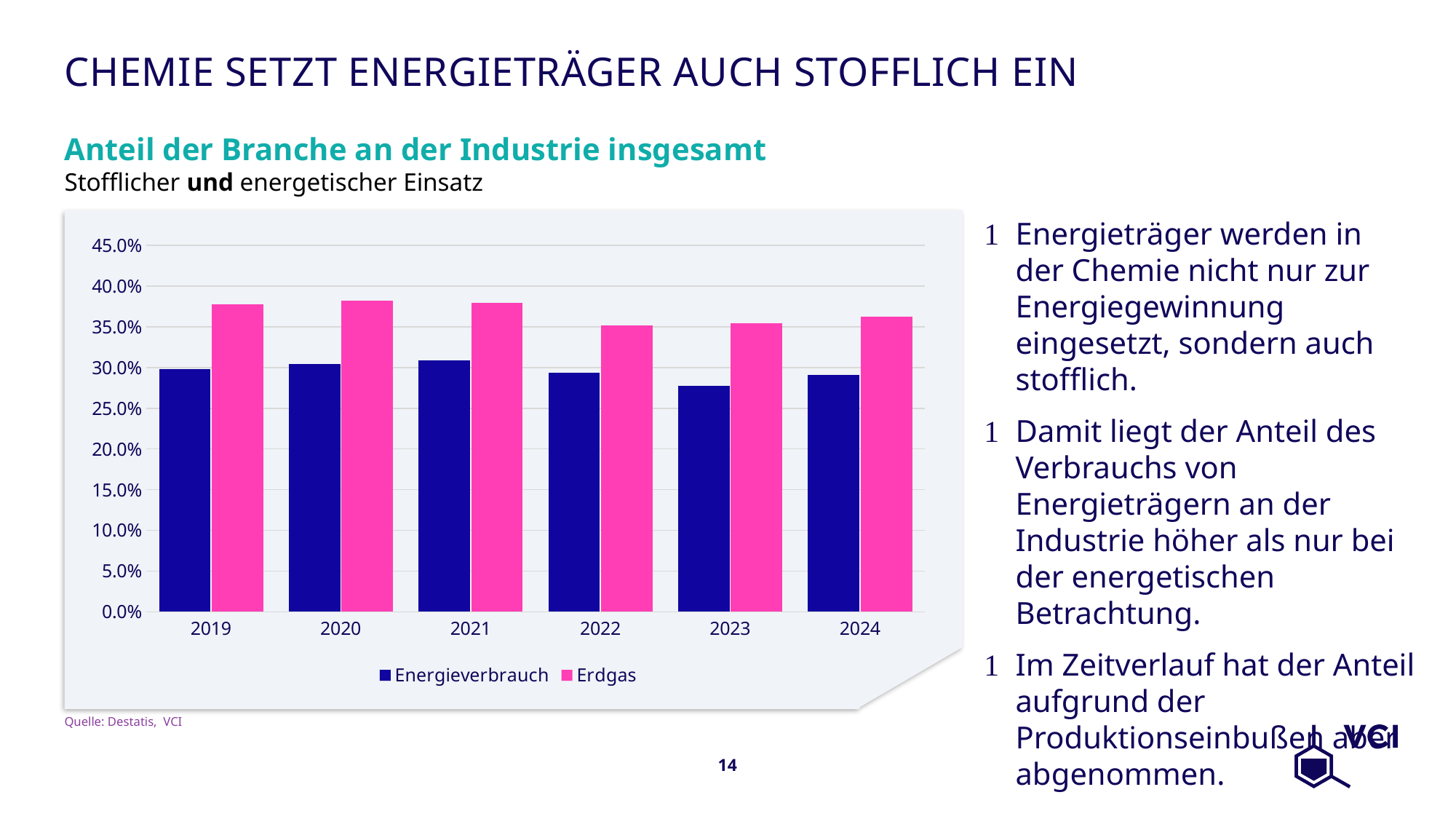
Is the Erdgas value for 2019 greater or less than 35.0%? greater How many years are shown on the x axis? 6 Does the Erdgas value rise or fall from 2021 to 2022? fall How many series does the legend list? 2 Which year has the larger Energieverbrauch value, 2021 or 2023? 2021 Which series is shown in pink? Erdgas Is the Erdgas value for 2024 greater or less than 40.0%? less Is the Energieverbrauch value for 2023 greater or less than 30.0%? less What is the title of the chart? Anteil der Branche an der Industrie insgesamt Which is larger in 2022, Energieverbrauch or Erdgas? Erdgas What kind of chart is shown on the slide? bar chart In which year is the Energieverbrauch value lowest? 2023